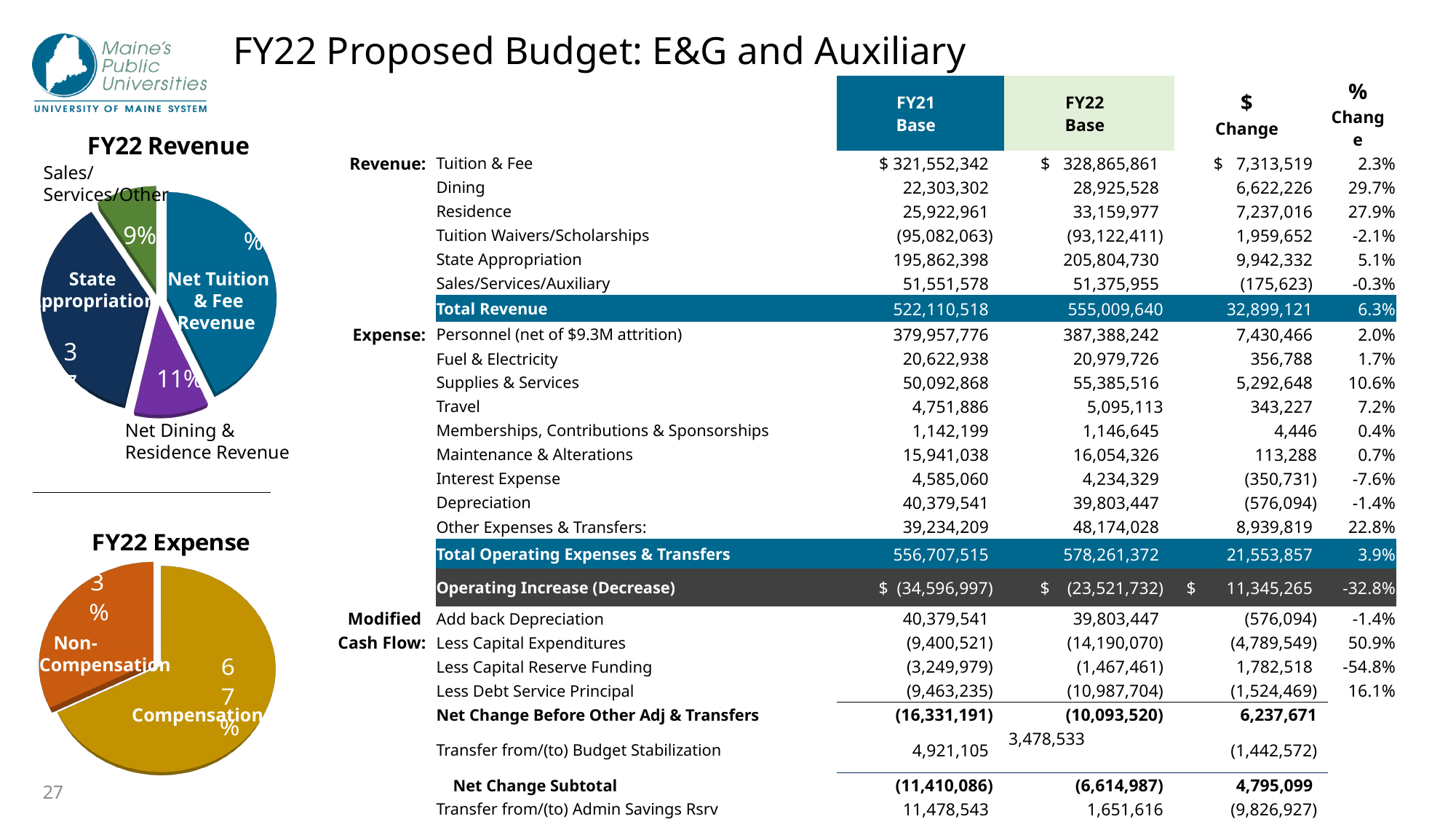
How many slices does the FY22 Revenue pie chart have? 4 In the FY22 Revenue pie chart, which is larger: Net Dining & Residence Revenue or Sales/Services/Other? Net Dining & Residence Revenue In the FY22 Expense pie chart, which is larger: Compensation or Non-Compensation? Compensation In the FY22 Revenue pie chart, which category has the largest slice? Net Tuition & Fee Revenue In the FY22 Revenue pie chart, what share is Sales/Services/Other? 9% In the FY22 Revenue pie chart, how many percentage points larger is Net Dining & Residence Revenue than Sales/Services/Other? 2 percentage points In the FY22 Revenue pie chart, what share is Net Dining & Residence Revenue? 11% What is the title of the lower pie chart on the slide? FY22 Expense How many slices does the FY22 Expense pie chart have? 2 In the FY22 Expense pie chart, which category has the largest slice? Compensation What kind of chart is the FY22 Expense chart? pie chart What kind of chart is the FY22 Revenue chart? pie chart